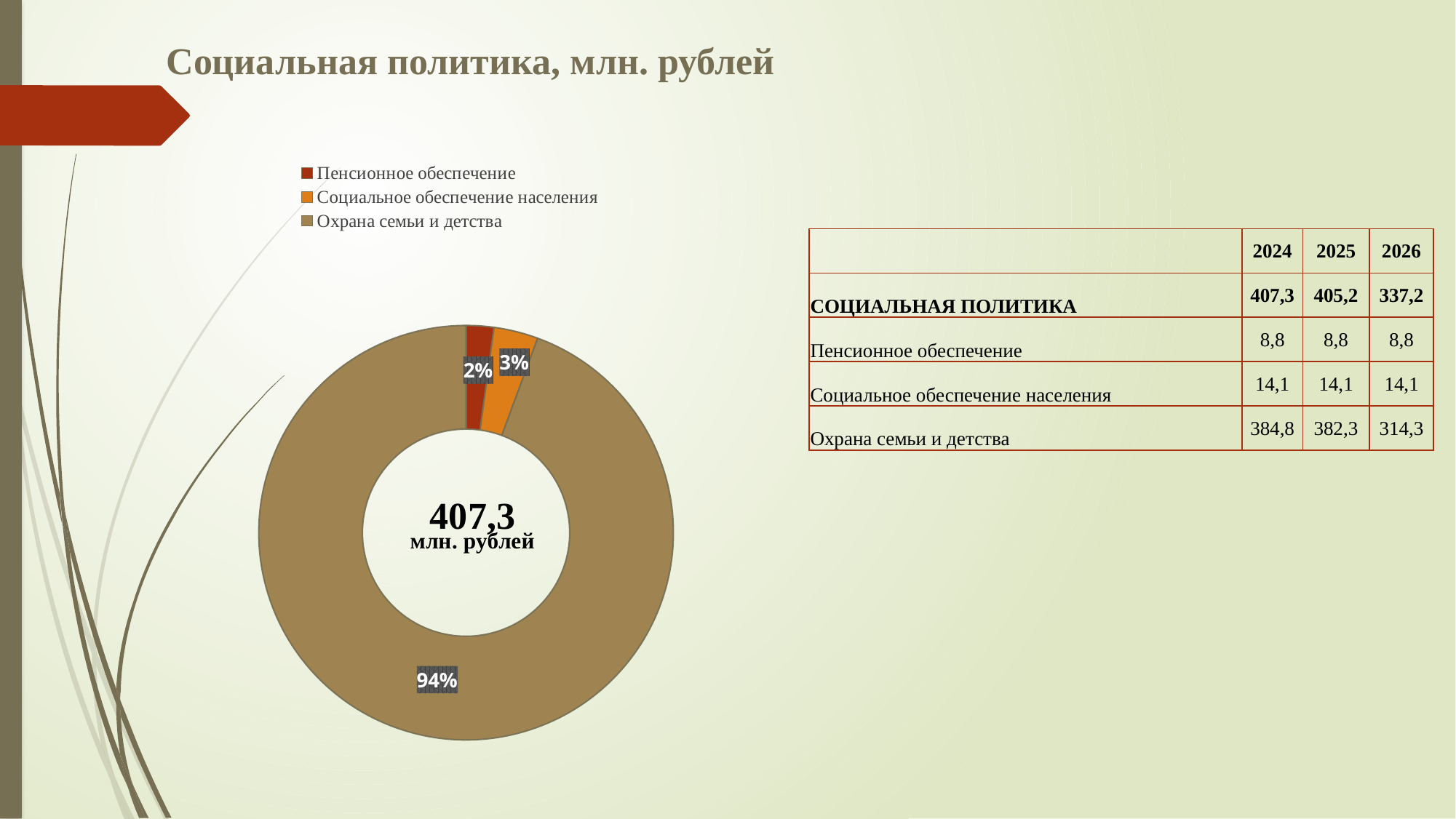
What total value is printed in the centre of the doughnut chart? 407,3 млн. рублей Which category has the smallest slice in the doughnut chart? Пенсионное обеспечение What share of the doughnut chart does Охрана семьи и детства take? 94% What is the difference in percentage points between the Охрана семьи и детства slice and the Социальное обеспечение населения slice? 91 percentage points What is the title of the slide containing the doughnut chart? Социальная политика, млн. рублей How many slices does the doughnut chart have? 3 Which slice is larger: Социальное обеспечение населения or Пенсионное обеспечение? Социальное обеспечение населения What share of the doughnut chart does Пенсионное обеспечение take? 2% What share of the doughnut chart does Социальное обеспечение населения take? 3% How many entries does the chart legend list? 3 Which category has the largest slice in the doughnut chart? Охрана семьи и детства What kind of chart is shown on the slide? Doughnut (pie) chart